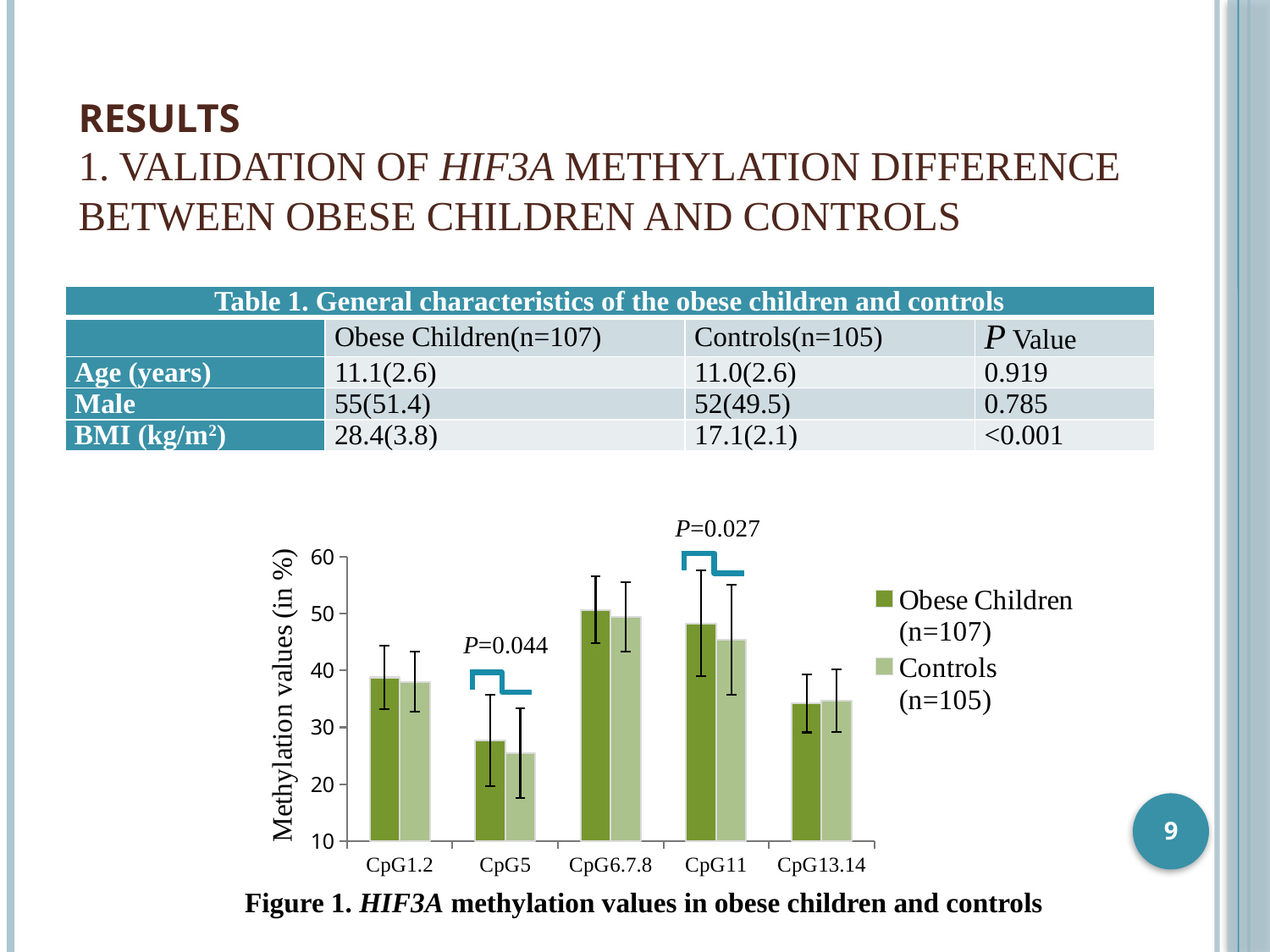
In Figure 1, is the methylation value for Controls at CpG5 greater or less than 30? less What P value is shown above the CpG5 bars in Figure 1? P=0.044 In Figure 1, which CpG site has the lowest methylation value for Controls? CpG5 In Figure 1, at CpG11, which group has the higher methylation value, Obese Children or Controls? Obese Children How many CpG site categories are shown on the x axis of Figure 1? 5 In Figure 1, which CpG site has the highest methylation value for Obese Children? CpG6.7.8 How many series does the legend of Figure 1 list? 2 What kind of chart is Figure 1? bar chart In Figure 1, is the methylation value for Controls at CpG11 greater or less than 40? greater What is the y-axis label of Figure 1? Methylation values (in %) In Figure 1, is the methylation value for Obese Children at CpG1.2 greater or less than 40? less